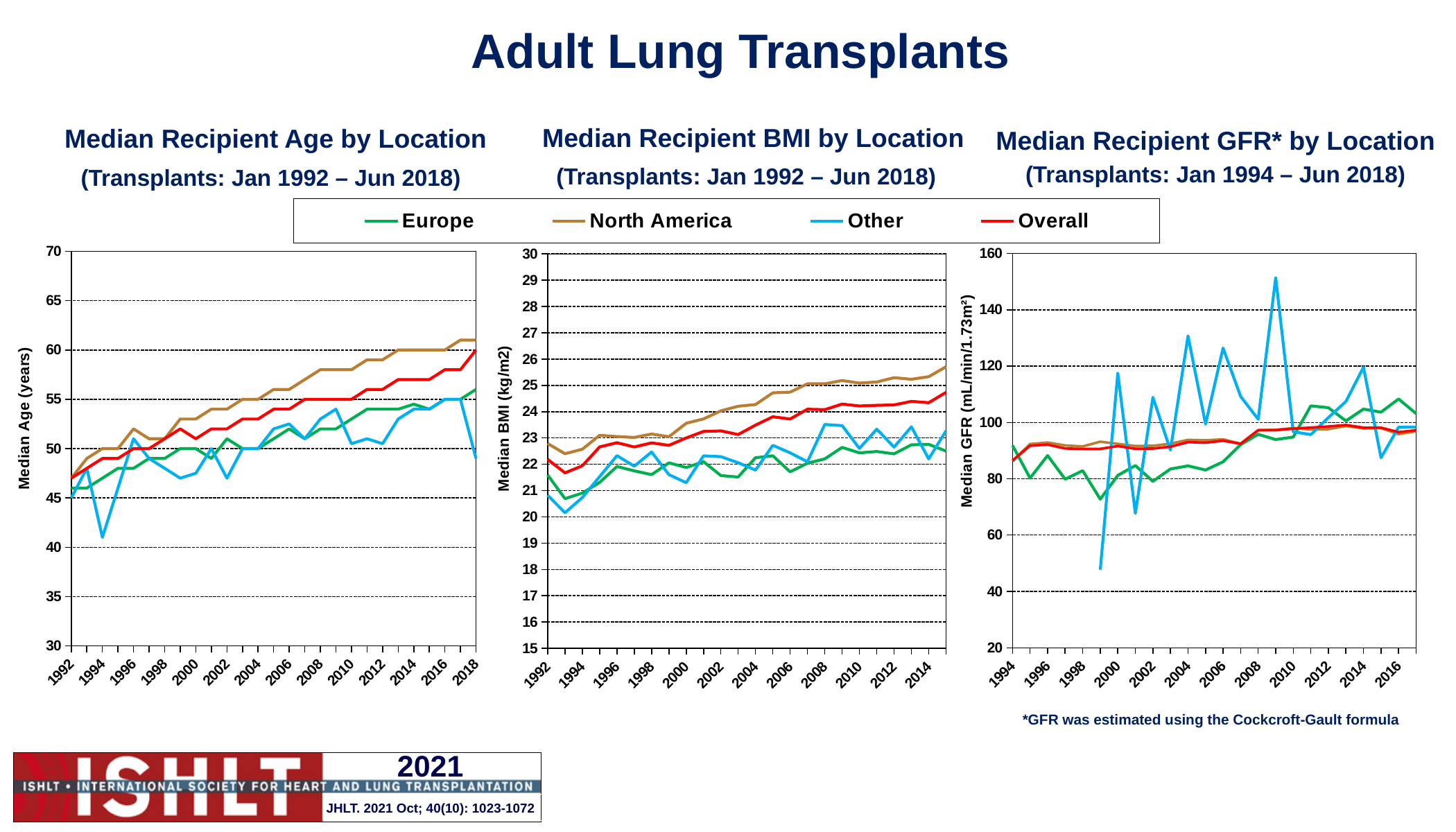
In the Median Recipient Age by Location chart, does the Overall series generally rise or fall from 1992 to 2018? rise What is the y-axis label of the Median Recipient GFR by Location chart? Median GFR (mL/min/1.73m²) In the Median Recipient GFR by Location chart, is the Other value in 2009 greater or less than 140? greater How many series does the shared legend list for the three charts? 4 What kind of chart is the Median Recipient Age by Location chart? line chart In the Median Recipient Age by Location chart, is the Other value in 1994 greater or less than 45? less In the Median Recipient GFR by Location chart, which is higher in 1999, Europe or Other? Europe In the Median Recipient BMI by Location chart, which series has the lowest value in 1993? Other In the Median Recipient BMI by Location chart, is the North America value in 2015 greater or less than 25? greater In the Median Recipient Age by Location chart, which series has the highest value in 2018? North America According to the footnote, which formula was used to estimate GFR in the Median Recipient GFR by Location chart? Cockcroft-Gault formula